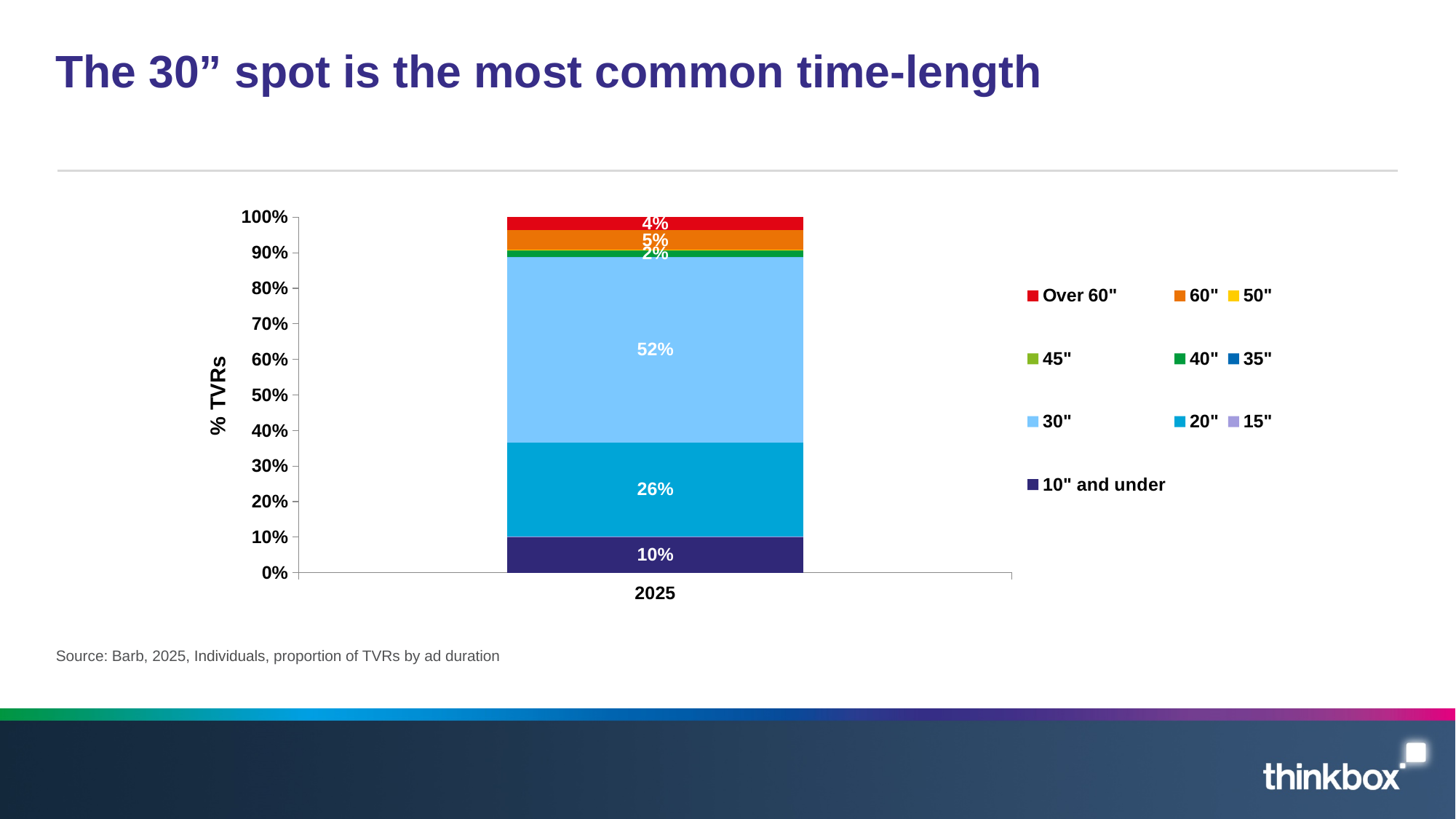
What is the label on the vertical axis? % TVRs What percentage of TVRs does the 30" segment account for in the 2025 bar? 52% What is the value shown for the 20" segment in 2025? 26% What percentage is labelled for the 60" segment? 5% What share of TVRs is labelled for the 10" and under segment? 10% How many percentage points larger is the 30" segment than the 20" segment? 26% Which ad duration has the largest share of TVRs in 2025? 30" What value is shown for the Over 60" segment at the top of the bar? 4% How many series does the legend list? 10 Which is larger, the 20" segment or the 10" and under segment? 20" What kind of chart is shown on the slide? Stacked bar chart How many categories are shown on the x axis? 1